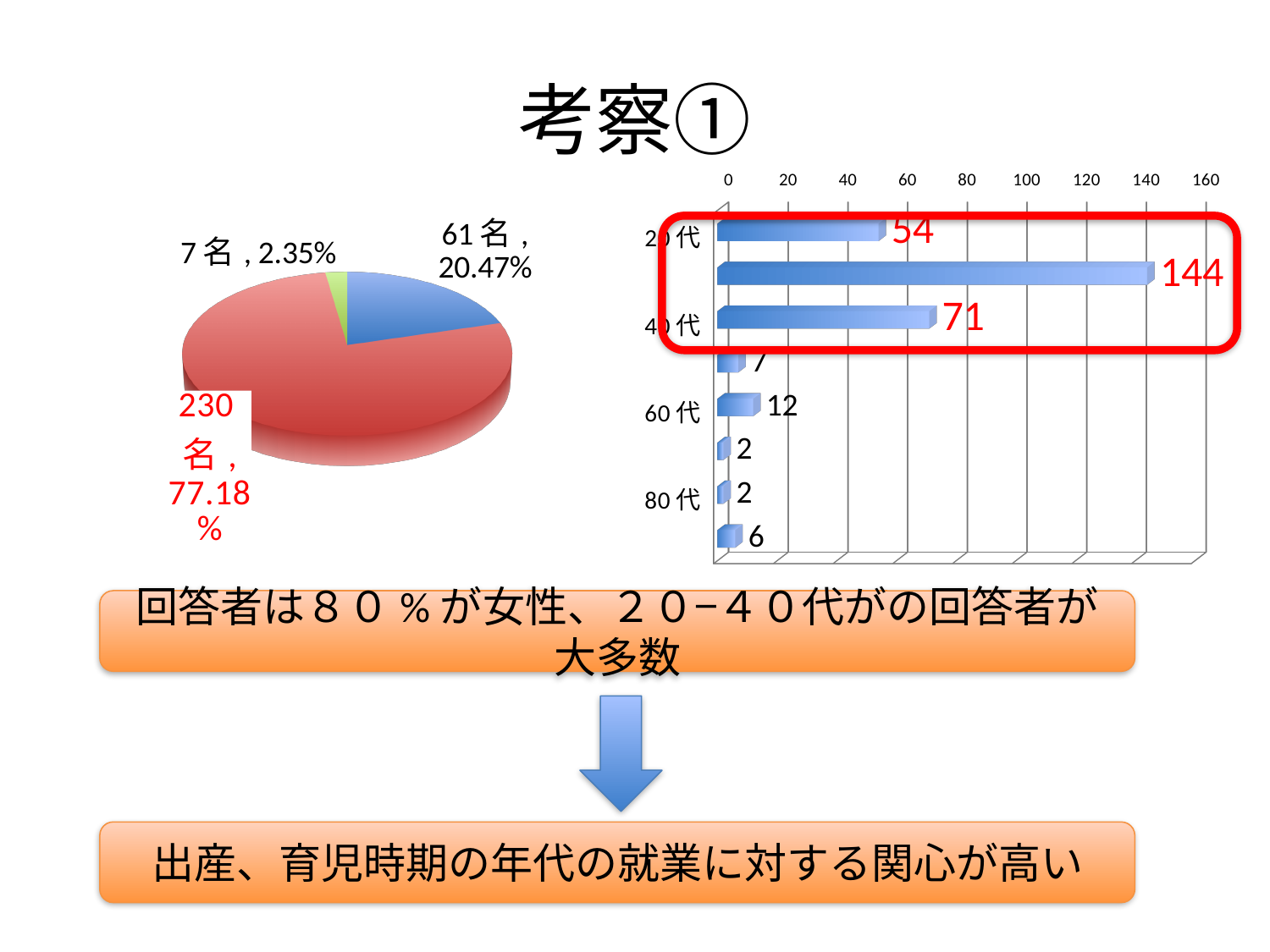
How many bars are plotted in the bar chart on the right? 8 What type of chart is the chart on the left side of the slide? pie chart In the bar chart on the right, what is the value for 20代? 54 In the bar chart on the right, which has the larger value, 20代 or 40代? 40代 In the bar chart on the right, what is the value for 80代? 2 In the bar chart on the right, what is the difference between the values for 40代 and 20代? 17 In the bar chart on the right, what is the largest value shown on any bar? 144 In the bar chart on the right, what is the value for 60代? 12 In the pie chart on the left, what share does the smallest (green) slice represent? 2.35% In the bar chart on the right, what is the value for 40代? 71 In the pie chart on the left, what share does the largest (red) slice represent? 77.18% What type of chart is the chart on the right side of the slide? bar chart